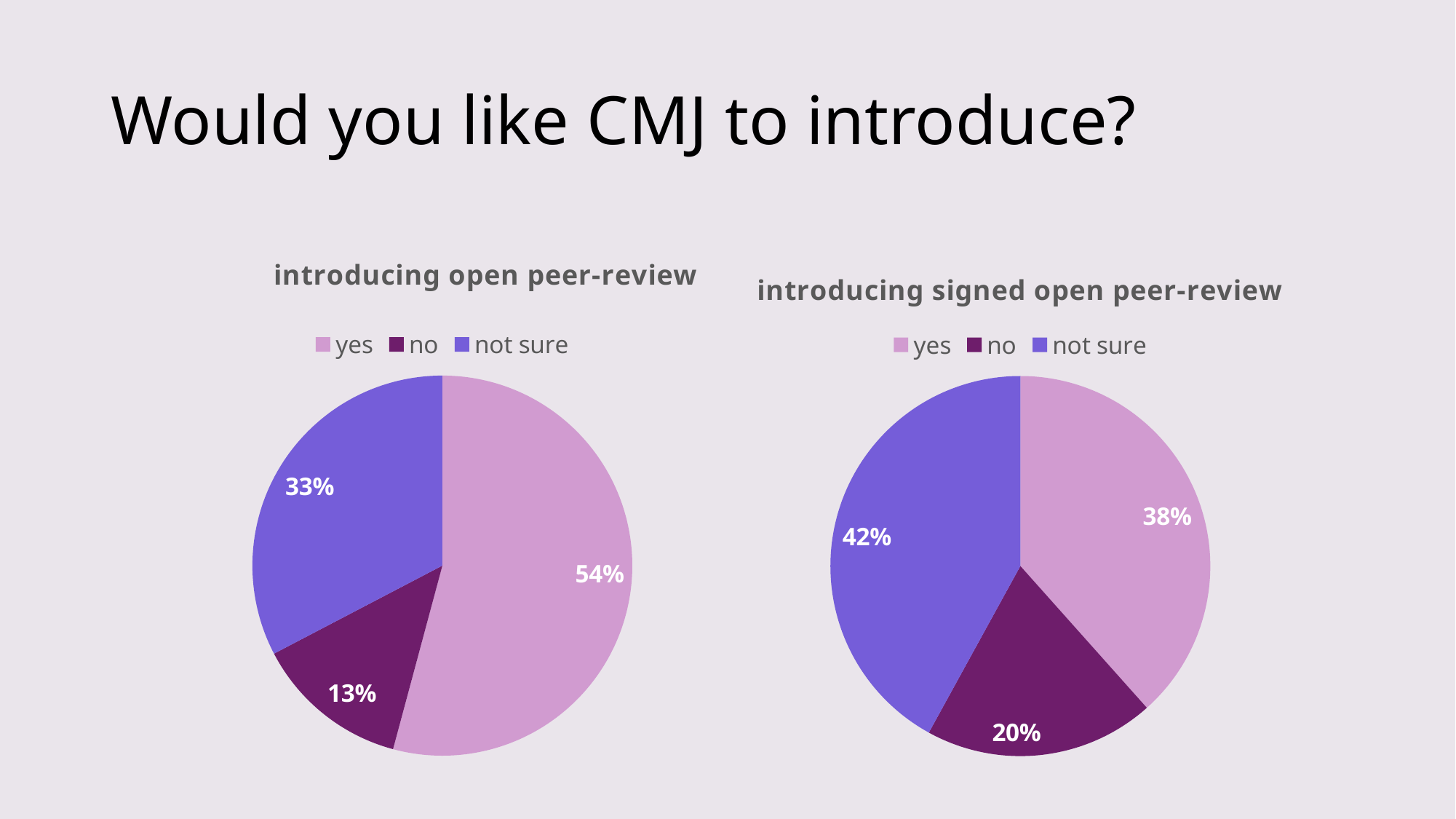
In the 'introducing open peer-review' chart, what is the difference between the 'yes' and 'not sure' shares? 21% In the 'introducing signed open peer-review' chart, which response has the largest share? not sure In the 'introducing signed open peer-review' chart, what percentage answered 'yes'? 38% In the 'introducing open peer-review' chart, what percentage answered 'no'? 13% In the 'introducing signed open peer-review' chart, which response has the smallest share? no In the 'introducing signed open peer-review' chart, what percentage answered 'not sure'? 42% What type of chart is used on the slide? pie chart Which chart has the larger 'no' share, 'introducing open peer-review' or 'introducing signed open peer-review'? introducing signed open peer-review In the 'introducing open peer-review' chart, which response has the largest share? yes In the 'introducing open peer-review' chart, what percentage answered 'yes'? 54% How many categories does the legend of the 'introducing open peer-review' chart list? 3 In the 'introducing signed open peer-review' chart, what colour is the 'not sure' slice? blue-purple